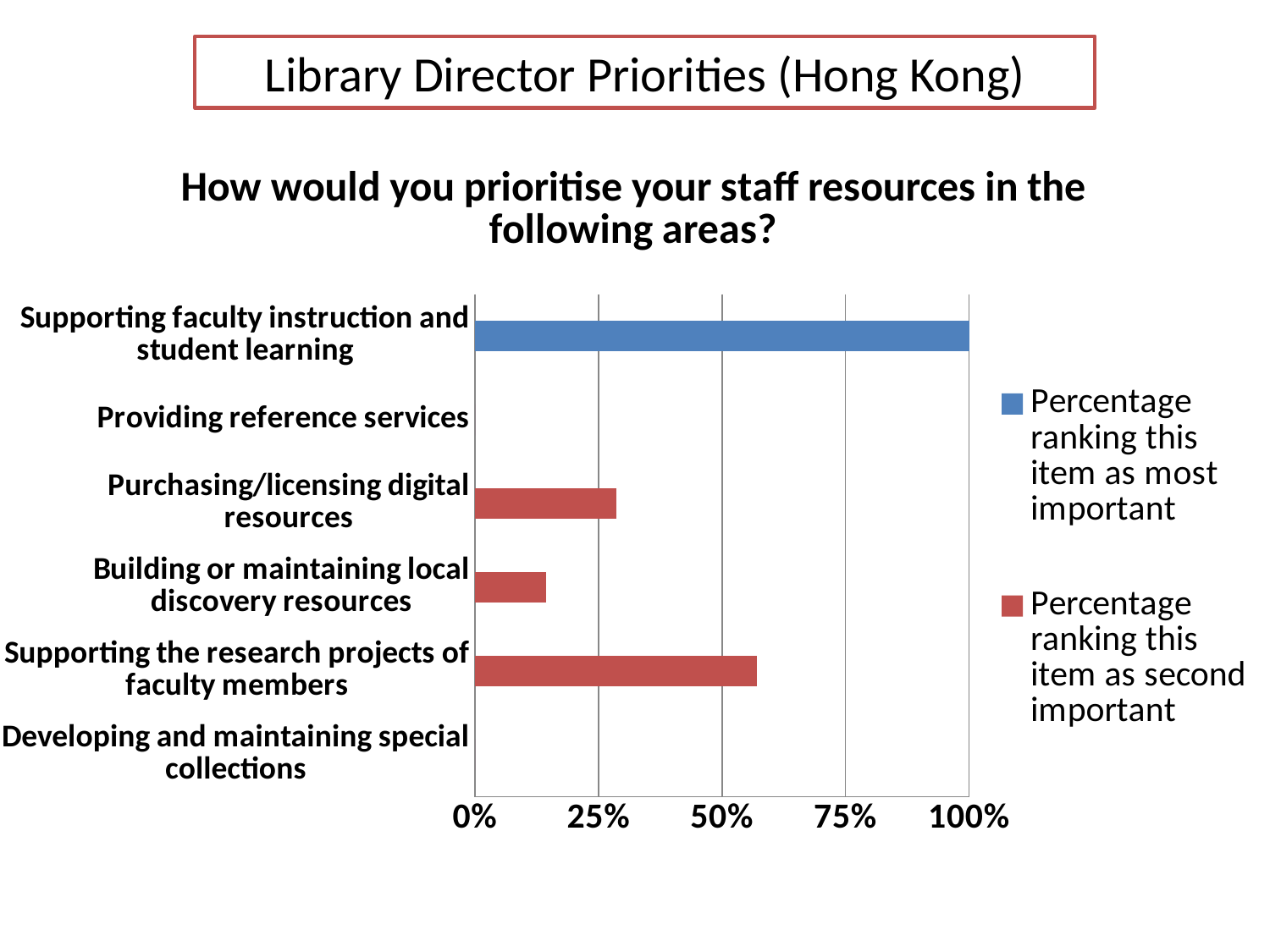
What is the title of the chart? How would you prioritise your staff resources in the following areas? How many categories are shown on the chart? 6 Among the categories with a visible bar in the 'Percentage ranking this item as second important' series, which has the lowest value? Building or maintaining local discovery resources Is the value for 'Supporting the research projects of faculty members' in the 'second important' series greater or less than 50%? greater Which category has the highest value in the 'Percentage ranking this item as second important' series? Supporting the research projects of faculty members Which is larger in the 'second important' series: 'Purchasing/licensing digital resources' or 'Building or maintaining local discovery resources'? Purchasing/licensing digital resources Is the value for 'Purchasing/licensing digital resources' in the 'second important' series greater or less than 50%? less How many series does the legend list? 2 What is the value for 'Supporting faculty instruction and student learning' in the 'Percentage ranking this item as most important' series? 100% What kind of chart is shown on the slide? Bar chart Is the value for 'Building or maintaining local discovery resources' in the 'second important' series greater or less than 25%? less Which colour represents the 'Percentage ranking this item as most important' series? Blue